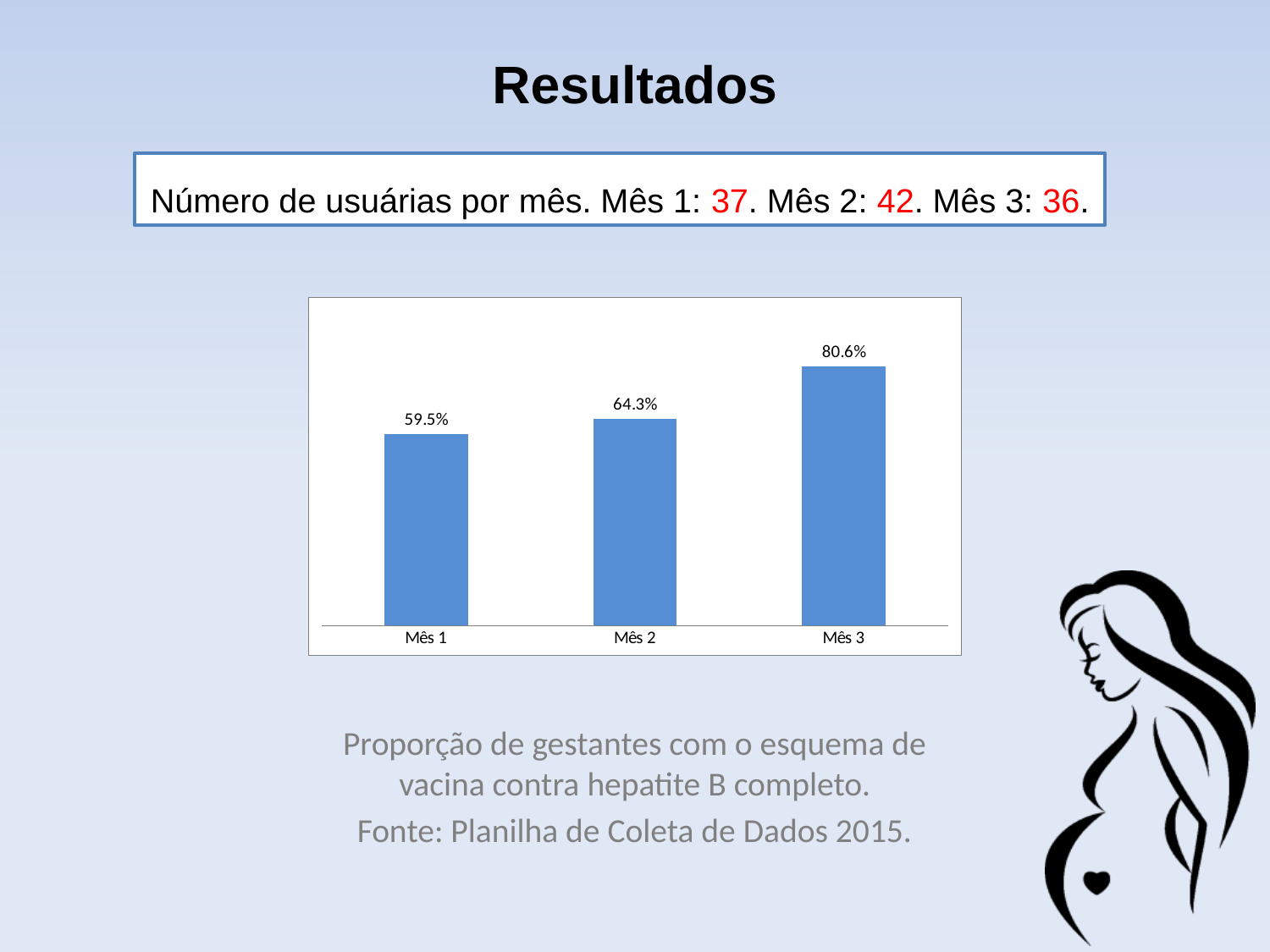
Which month has the lowest value? Mês 1 What kind of chart is shown on the slide? Bar chart Which is larger, the value for Mês 2 or the value for Mês 3? Mês 3 What is the value for Mês 3? 80.6% Do the values rise or fall from Mês 1 to Mês 3? Rise What is the difference between the values for Mês 3 and Mês 1? 21.1% Which month has the highest value? Mês 3 What is the value for Mês 2? 64.3% How many months are shown in the chart? 3 What is the difference between the values for Mês 2 and Mês 1? 4.8% What colour are the bars in the chart? Blue What is the value for Mês 1? 59.5%